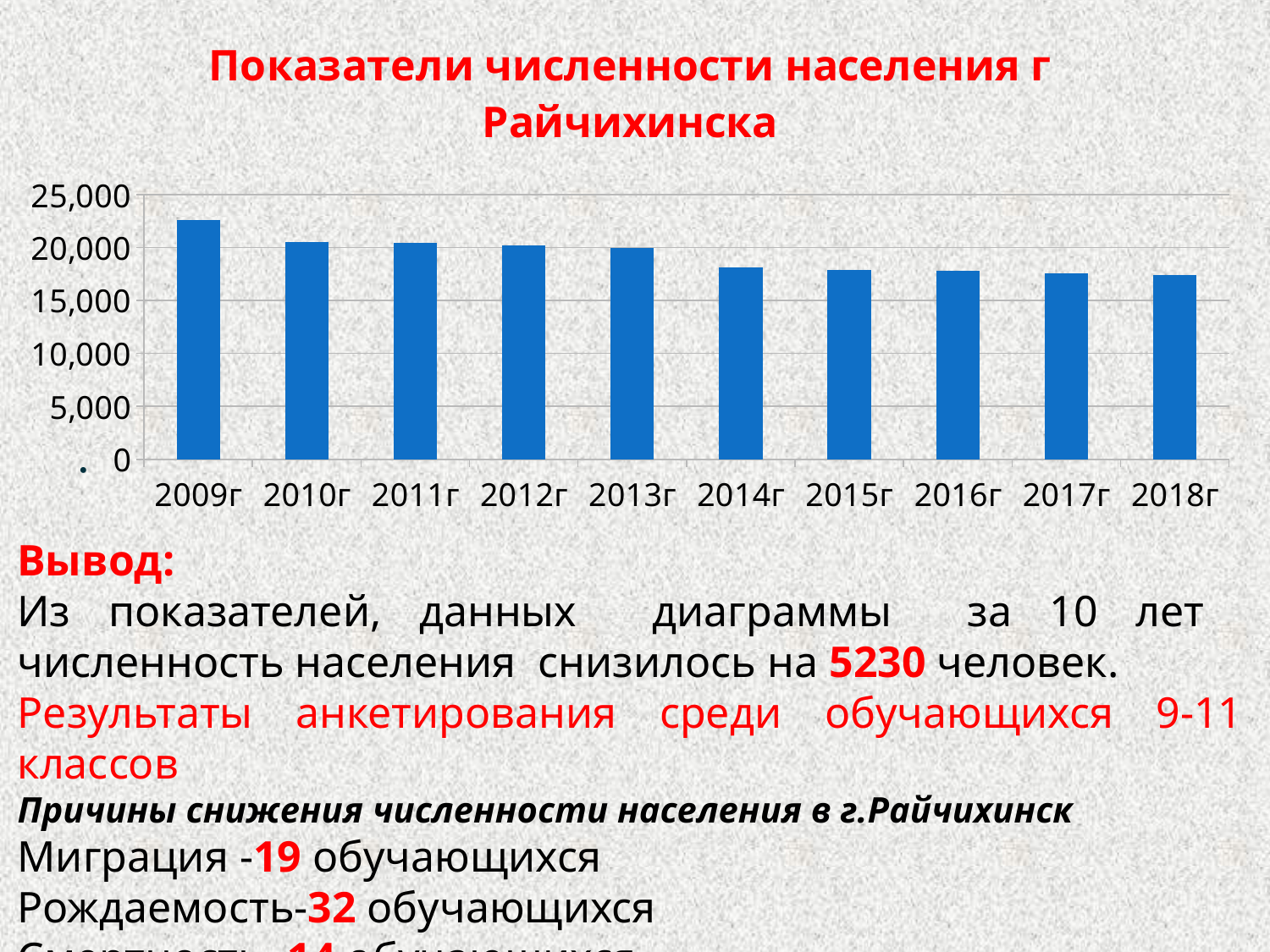
Which year has the highest population value in the chart? 2009г What is the title of the chart on the slide? Показатели численности населения г Райчихинска Is the value for 2014г greater or less than 20,000? less Is the value for 2018г greater or less than 15,000? greater Do the values in the chart rise or fall from 2009г to 2018г? fall How many years are shown on the x axis of the chart? 10 Which is larger, the value for 2009г or the value for 2010г? 2009г Is the value for 2016г greater or less than 20,000? less What kind of chart is shown on the slide? bar chart Which is larger, the value for 2011г or the value for 2015г? 2011г What is the highest tick value shown on the y axis of the chart? 25,000